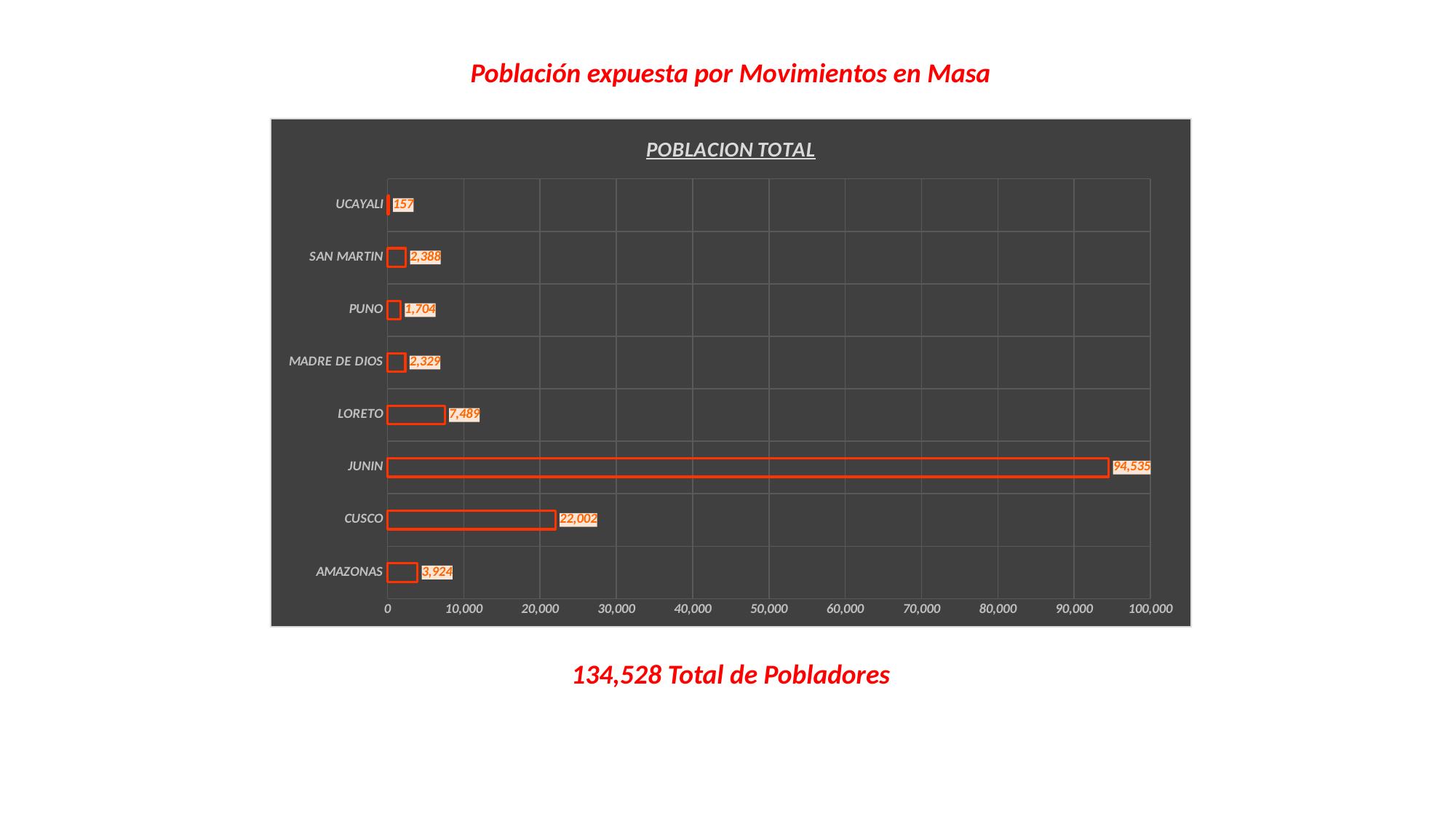
What is the value for CUSCO? 22,002 What is the value for UCAYALI? 157 Which category has the lowest value? UCAYALI What kind of chart is shown? bar chart What is the difference between the values for JUNIN and CUSCO? 72,533 Which category has the highest value? JUNIN What is the title of the chart? POBLACION TOTAL Is the value for CUSCO greater or less than 20,000? greater What is the value for LORETO? 7,489 How many categories are shown in the chart? 8 Which is larger, the value for SAN MARTIN or the value for MADRE DE DIOS? SAN MARTIN What is the value for JUNIN? 94,535